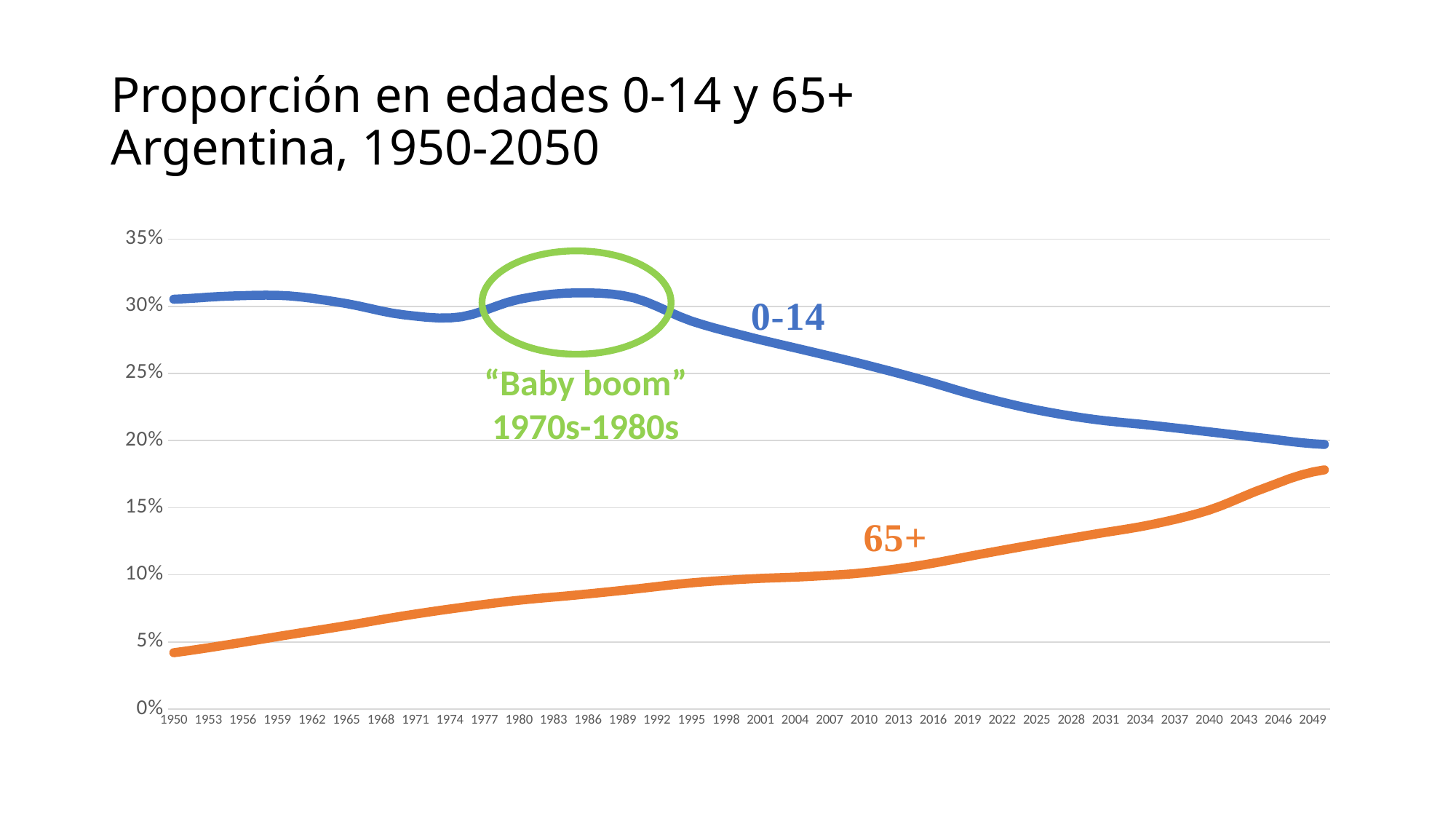
Is the value for 65+ in 2049 greater or less than 15%? greater Does the 0-14 series rise or fall overall from 1950 to 2049? Falls Is the value for 65+ in 1950 greater or less than 5%? less Which series has the higher value in 2049, 0-14 or 65+? 0-14 Does the 65+ series rise or fall from 1950 to 2049? Rises What period does the green circle annotation on the chart label as the "Baby boom"? 1970s-1980s Is the value for 65+ in 1980 greater or less than 10%? less What kind of chart is shown on the slide? Line chart How many series are plotted on the chart? 2 Which series has the higher value in 1950, 0-14 or 65+? 0-14 What is the title of the chart? Proporción en edades 0-14 y 65+ Argentina, 1950-2050